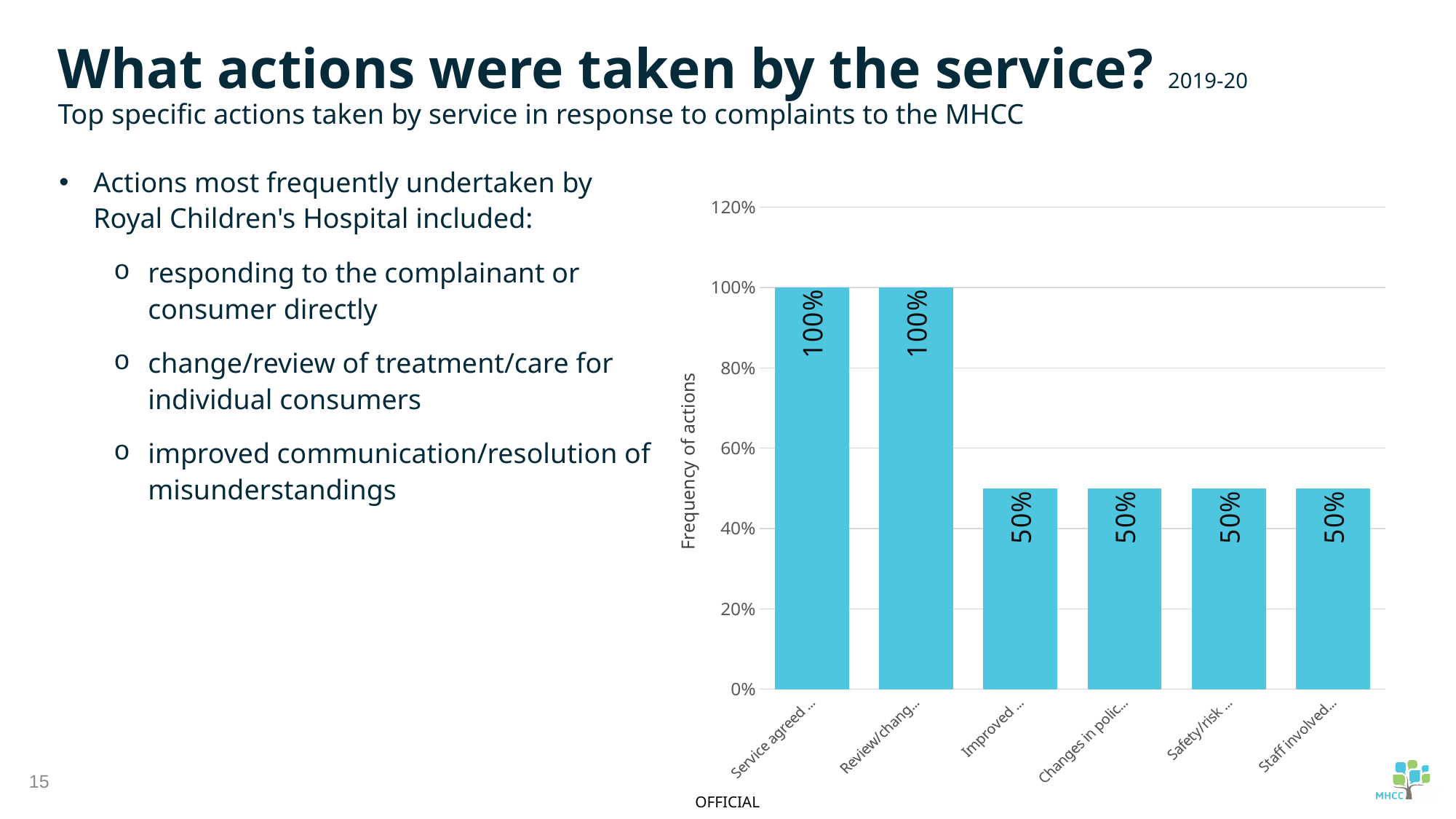
What is the value of the bar labelled "Service agreed ..."? 100% What is the value of the bar labelled "Safety/risk ..."? 50% How many bars show a value of 50%? 4 How many bars show a value of 100%? 2 What is the difference between the "Review/chang..." bar and the "Improved ..." bar? 50% Do the bar values rise or fall from left to right across the chart? fall Which is larger, the "Service agreed ..." bar or the "Staff involved..." bar? Service agreed ... Is the value for "Improved ..." greater or less than 60%? less What kind of chart is shown on the slide? bar chart How many bars are plotted in the chart? 6 What is the label on the vertical axis of the chart? Frequency of actions What is the value of the bar labelled "Changes in polic..."? 50%